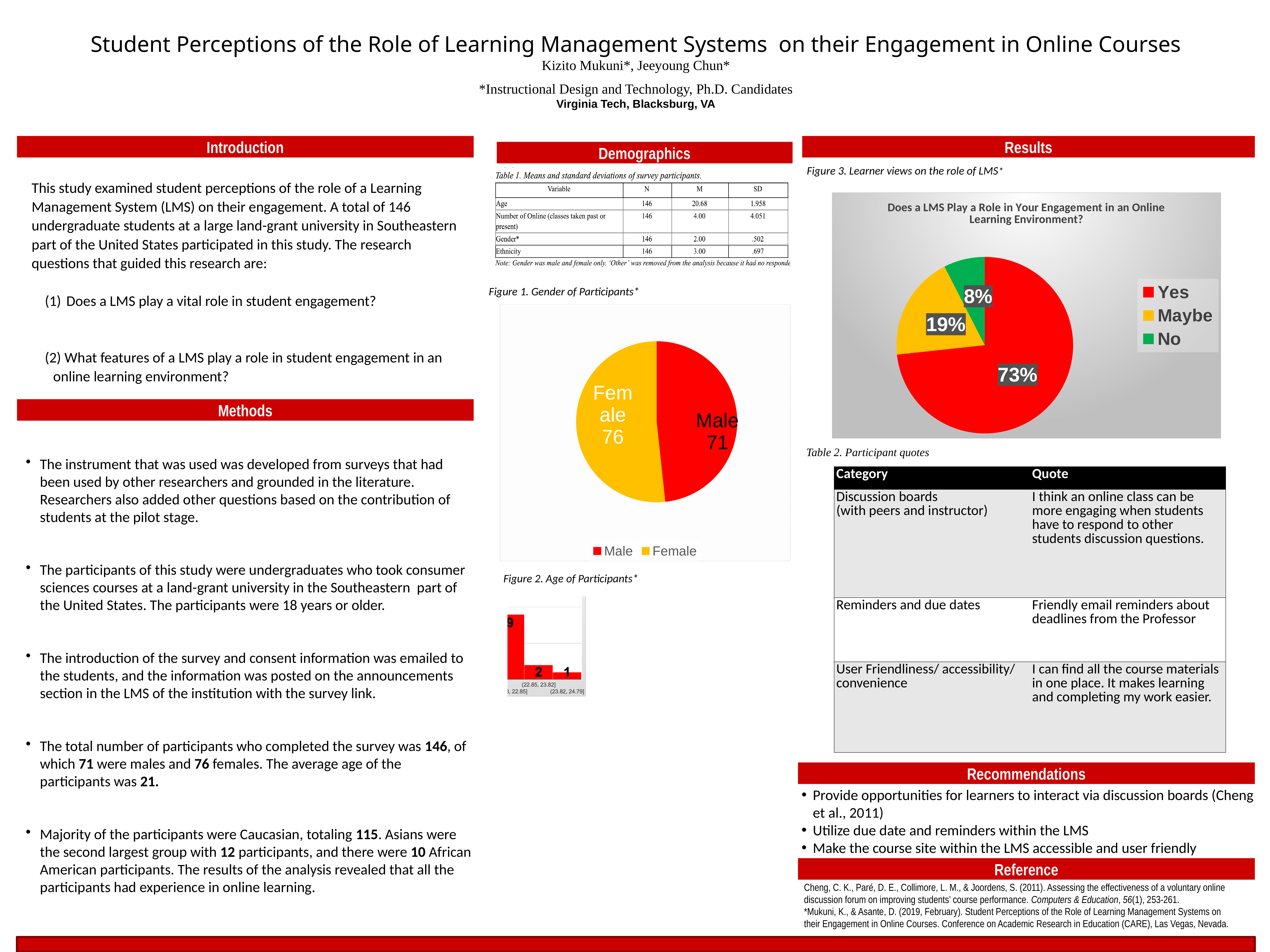
In the Figure 3 pie chart on the role of LMS, which response has the largest share? Yes In the Figure 1 gender pie chart, what is the difference between the number of females and the number of males? 5 In the Figure 1 gender pie chart, how many participants are male? 71 In the Figure 3 pie chart on the role of LMS, what percentage of learners answered Yes? 73% In the Figure 1 gender pie chart, how many categories does the legend list? 2 In the Figure 3 pie chart on the role of LMS, what percentage of learners answered Maybe? 19% What type of chart is Figure 1, Gender of Participants? Pie chart In the Figure 1 gender pie chart, how many participants are female? 76 In the Figure 1 gender pie chart, which group is larger, Male or Female? Female In the Figure 3 pie chart on the role of LMS, what is the difference between the Yes and Maybe percentages? 54% In the Figure 3 pie chart on the role of LMS, which response has the smallest share? No In the Figure 3 pie chart, what colour represents the No response? Green